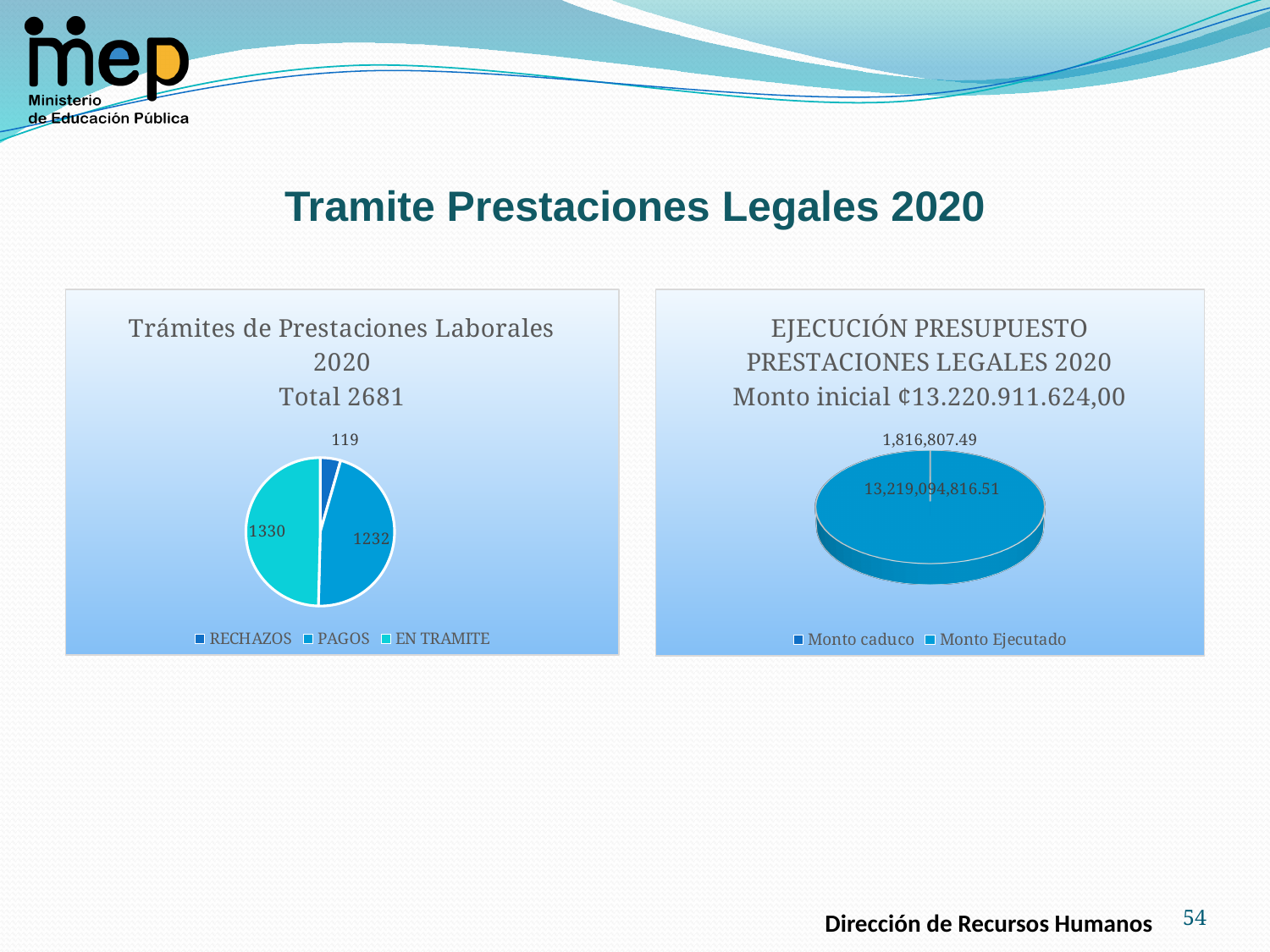
How many categories does the legend of the left chart (Trámites de Prestaciones Laborales 2020) list? 3 In the left chart (Trámites de Prestaciones Laborales 2020), what is the value for PAGOS? 1232 In the left chart (Trámites de Prestaciones Laborales 2020), what is the value for EN TRAMITE? 1330 In the left chart (Trámites de Prestaciones Laborales 2020), which category has the smallest slice? RECHAZOS In the left chart (Trámites de Prestaciones Laborales 2020), what is the value for RECHAZOS? 119 In the left chart (Trámites de Prestaciones Laborales 2020), what total is stated in the chart title? 2681 In the right chart (EJECUCIÓN PRESUPUESTO PRESTACIONES LEGALES 2020), what is the value for Monto Ejecutado? 13,219,094,816.51 In the left chart (Trámites de Prestaciones Laborales 2020), what is the difference between EN TRAMITE and PAGOS? 98 In the right chart (EJECUCIÓN PRESUPUESTO PRESTACIONES LEGALES 2020), which is larger, Monto caduco or Monto Ejecutado? Monto Ejecutado What type of chart is the right chart (EJECUCIÓN PRESUPUESTO PRESTACIONES LEGALES 2020)? Pie chart In the right chart (EJECUCIÓN PRESUPUESTO PRESTACIONES LEGALES 2020), what is the value for Monto caduco? 1,816,807.49 In the left chart (Trámites de Prestaciones Laborales 2020), which category has the largest slice? EN TRAMITE